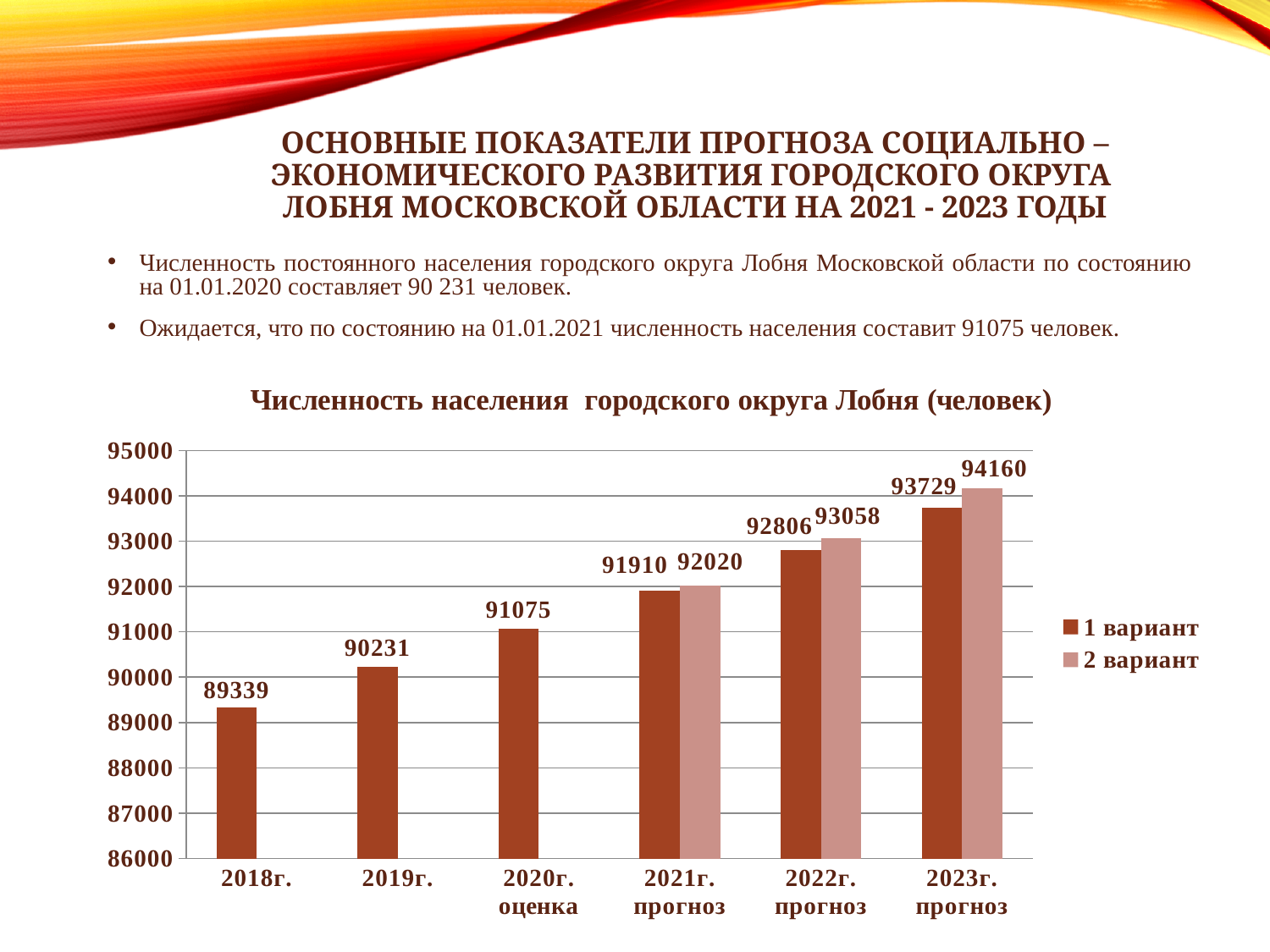
What is the value for 2018г. in the chart? 89339 Which category has the lowest value in the chart? 2018г. Which category has the highest value in the chart? 2023г. прогноз Do the values rise or fall from 2018г. to 2023г. прогноз? Rise What is the value of the 1 вариант series for 2022г. прогноз? 92806 How many series does the legend list? 2 What is the difference between the values for 2019г. and 2018г.? 892 What type of chart is shown on the slide? Bar chart How many categories are shown on the x axis of the chart? 6 What is the difference between the 2 вариант and 1 вариант values for 2023г. прогноз? 431 Which is larger for 2021г. прогноз: the 1 вариант value or the 2 вариант value? 2 вариант What is the value of the 2 вариант series for 2023г. прогноз? 94160